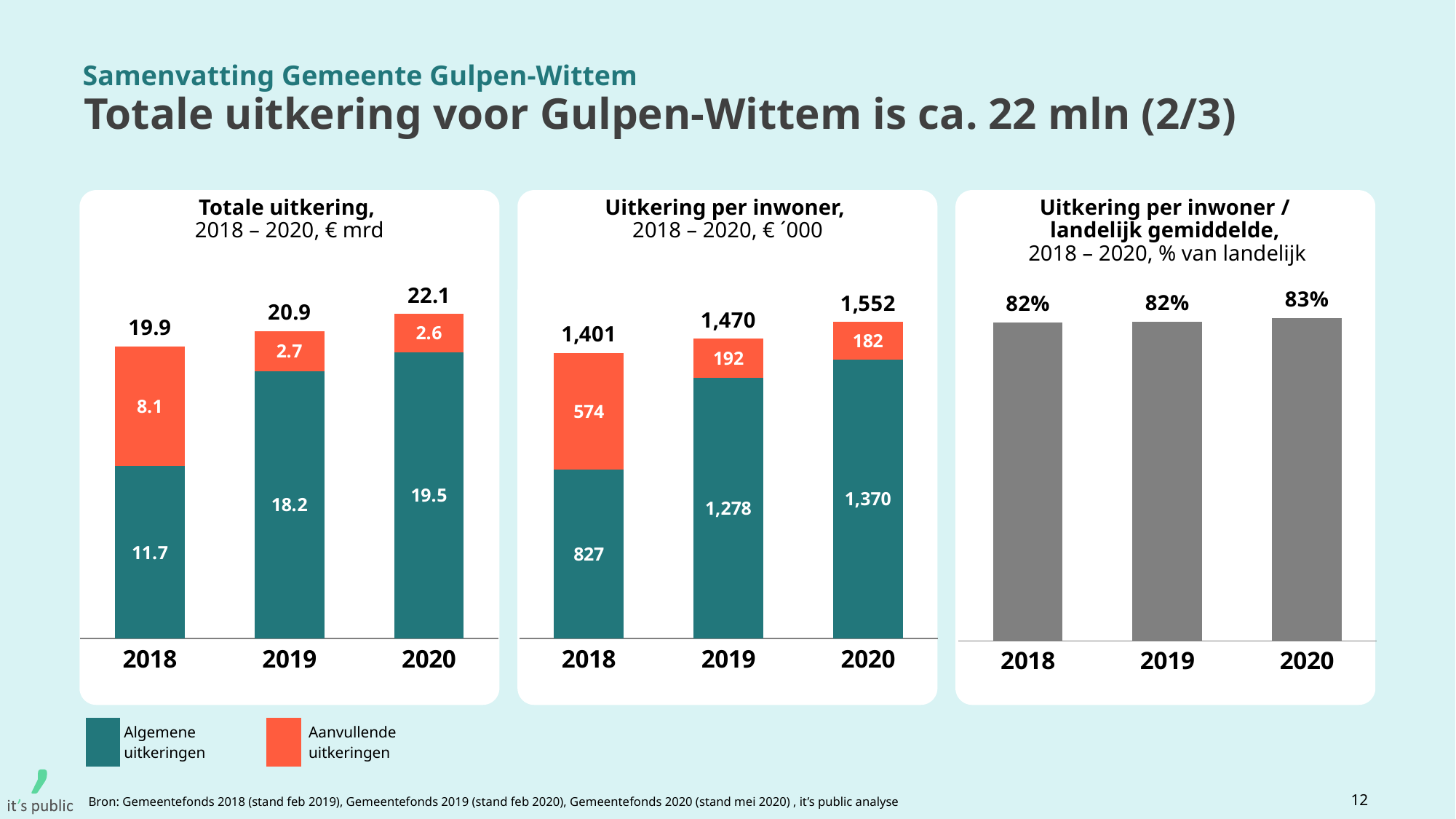
In the 'Uitkering per inwoner / landelijk gemiddelde' chart, what is the value for 2020? 83% Do the totals in the 'Totale uitkering' chart rise or fall from 2018 to 2020? rise In the 'Totale uitkering' chart, what is the total of the stacked bar for 2020? 22.1 How many series does the legend at the bottom of the slide list? 2 In the 'Uitkering per inwoner' chart, what is the difference between the Algemene uitkeringen values for 2020 and 2018? 543 In the 'Uitkering per inwoner' chart, which year has the highest total? 2020 In the 'Uitkering per inwoner' chart, what is the value of Aanvullende uitkeringen for 2019? 192 In the 'Totale uitkering' chart, what is the difference between the Aanvullende uitkeringen values for 2018 and 2019? 5.4 How many years are shown on the x axis of the 'Totale uitkering' chart? 3 In the 'Uitkering per inwoner / landelijk gemiddelde' chart, which year has the lowest value? 2018 and 2019 (both 82%) In the 'Totale uitkering' chart, is the Algemene uitkeringen value for 2019 larger or smaller than the Aanvullende uitkeringen value for 2019? larger In the 'Totale uitkering' chart, what is the value of Algemene uitkeringen for 2018? 11.7